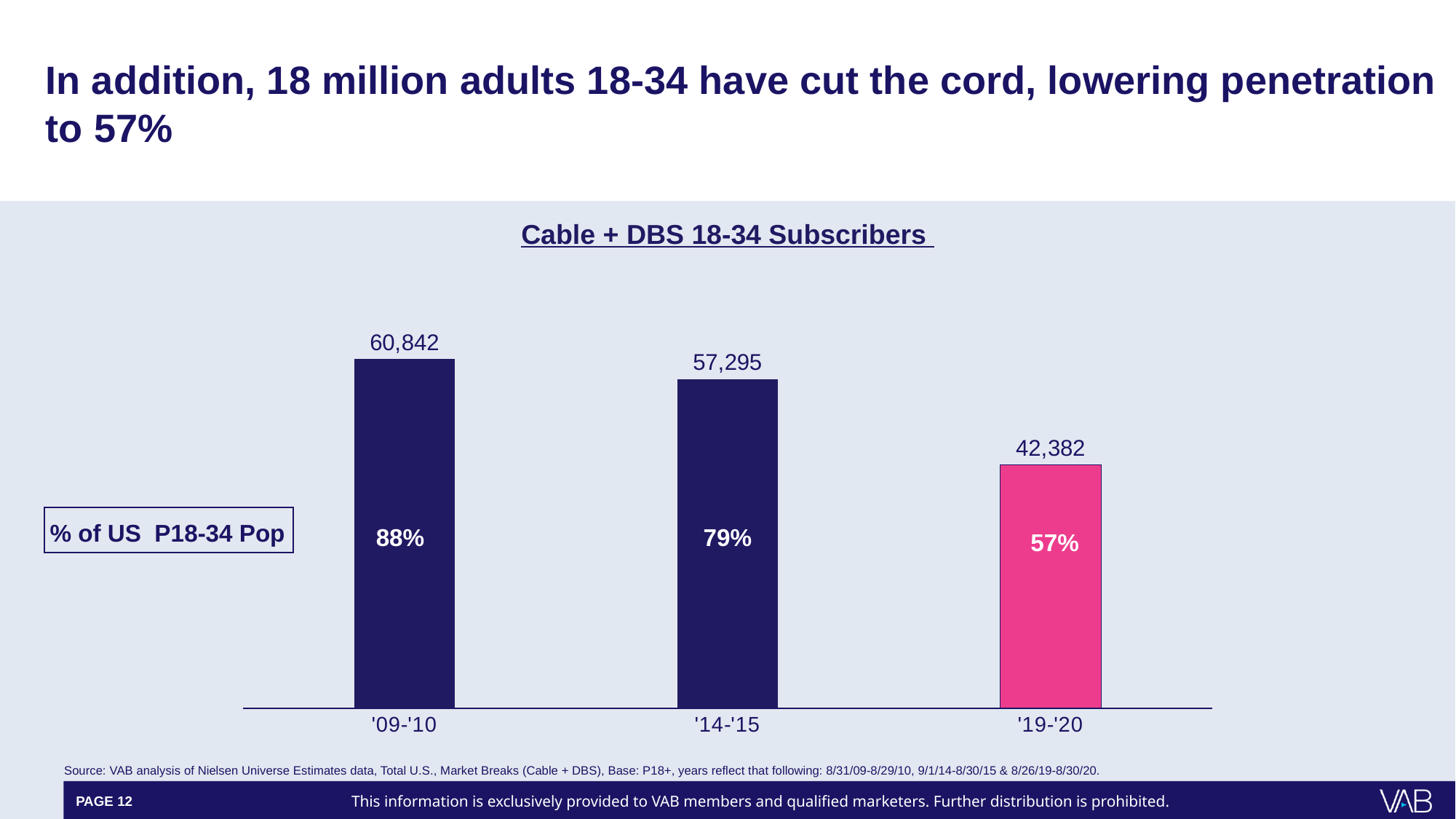
What percentage of the US P18-34 population is shown for '14-'15? 79% How many periods are shown on the x axis of the chart? 3 Which period has the highest number of Cable + DBS 18-34 subscribers? '09-'10 What kind of chart is shown on the slide? Bar chart What is the difference in subscribers between '09-'10 and '19-'20? 18,460 Which period has more subscribers, '14-'15 or '19-'20? '14-'15 Do the subscriber values rise or fall from '09-'10 to '19-'20? Fall What is the difference in percentage of US P18-34 population between '09-'10 and '14-'15? 9 percentage points What is the number of Cable + DBS 18-34 subscribers for '19-'20? 42,382 Which period has the lowest number of Cable + DBS 18-34 subscribers? '19-'20 What percentage of the US P18-34 population is shown for '19-'20? 57% What is the number of Cable + DBS 18-34 subscribers for '09-'10? 60,842